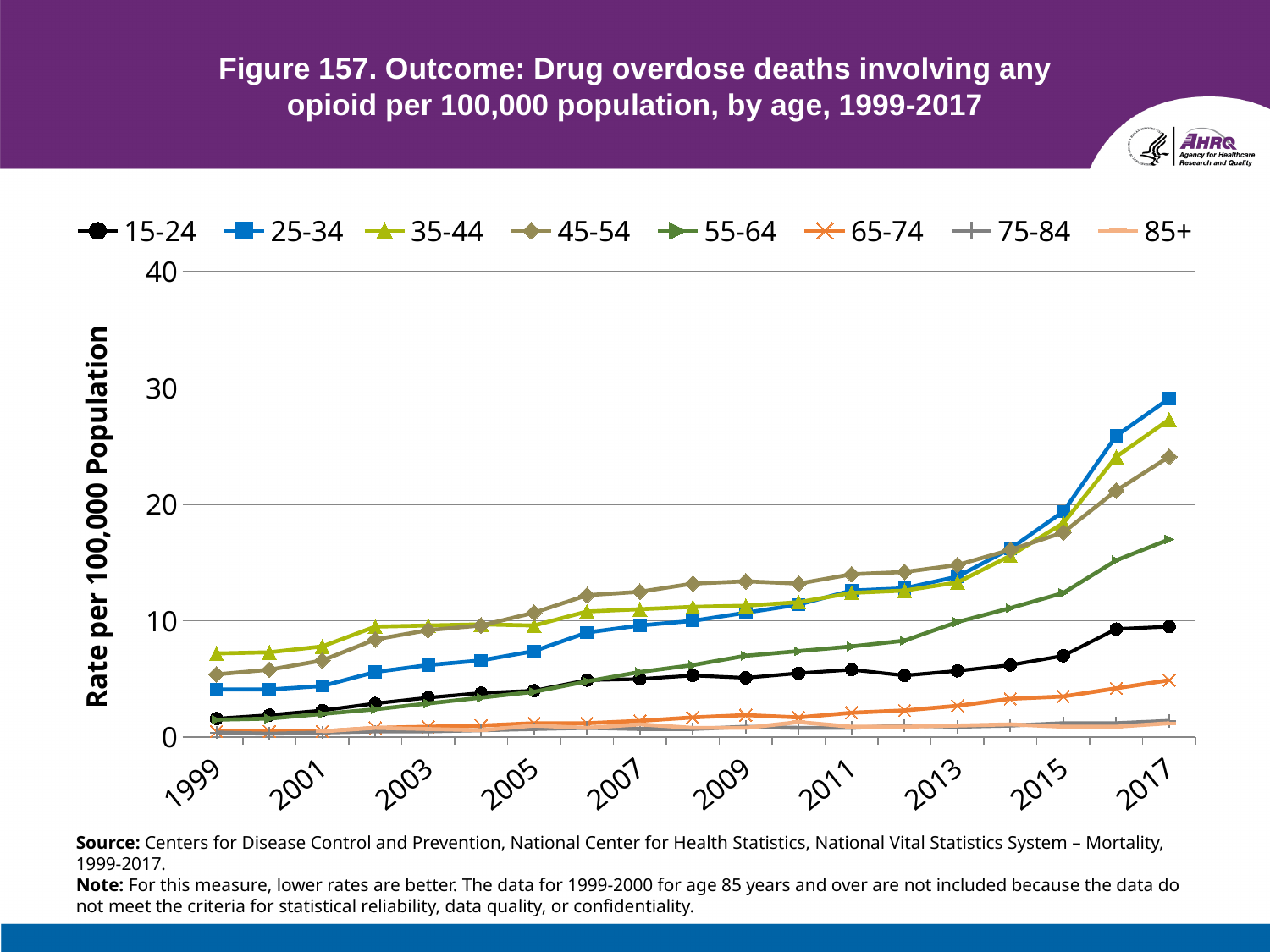
What is the label on the y axis? Rate per 100,000 Population Which age group has the highest rate in 2009? 45-54 What kind of chart is shown on the slide? line chart Does the rate for the 25-34 age group rise or fall from 1999 to 2017? rise Is the value for the 25-34 age group in 2017 greater or less than 20? greater Is the value for the 15-24 age group in 2017 greater or less than 10? less How many years of data are plotted along the x axis? 19 In 2017, which is larger: the rate for 45-54 or the rate for 55-64? 45-54 Is the value for the 65-74 age group in 2017 greater or less than 10? less Which age group has the highest rate in 1999? 35-44 Which age group has the highest rate in 2017? 25-34 How many age groups does the legend list? 8